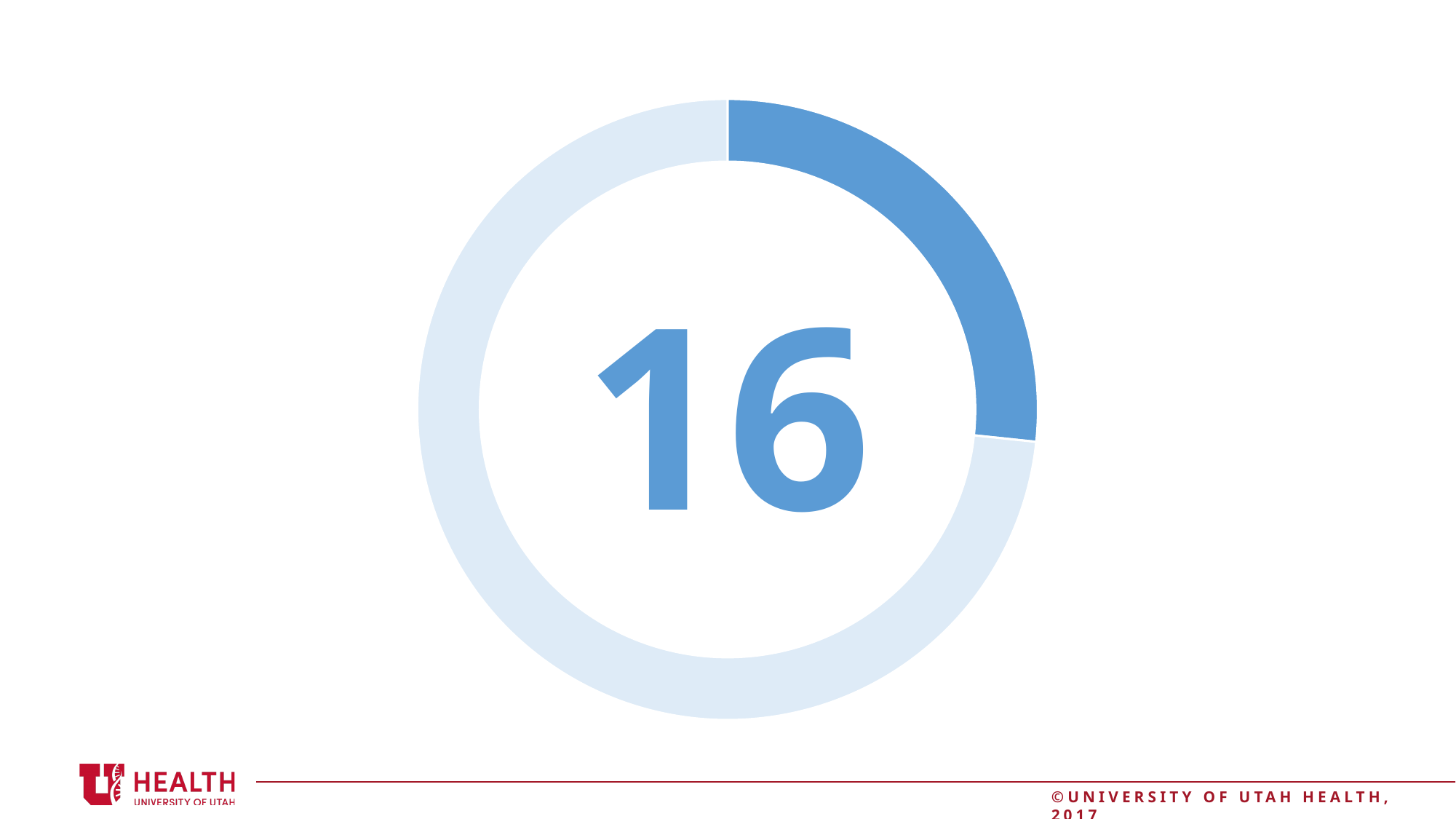
What number is displayed in the centre of the doughnut chart? 16 What colour is the smaller segment of the doughnut chart? Dark blue How many segments does the doughnut chart have? 2 Does the dark blue segment cover more or less than half of the ring? Less Does the doughnut chart display a legend? No Which segment of the doughnut chart is larger, the dark blue one or the light blue one? The light blue one What kind of chart is shown on the slide? Doughnut chart